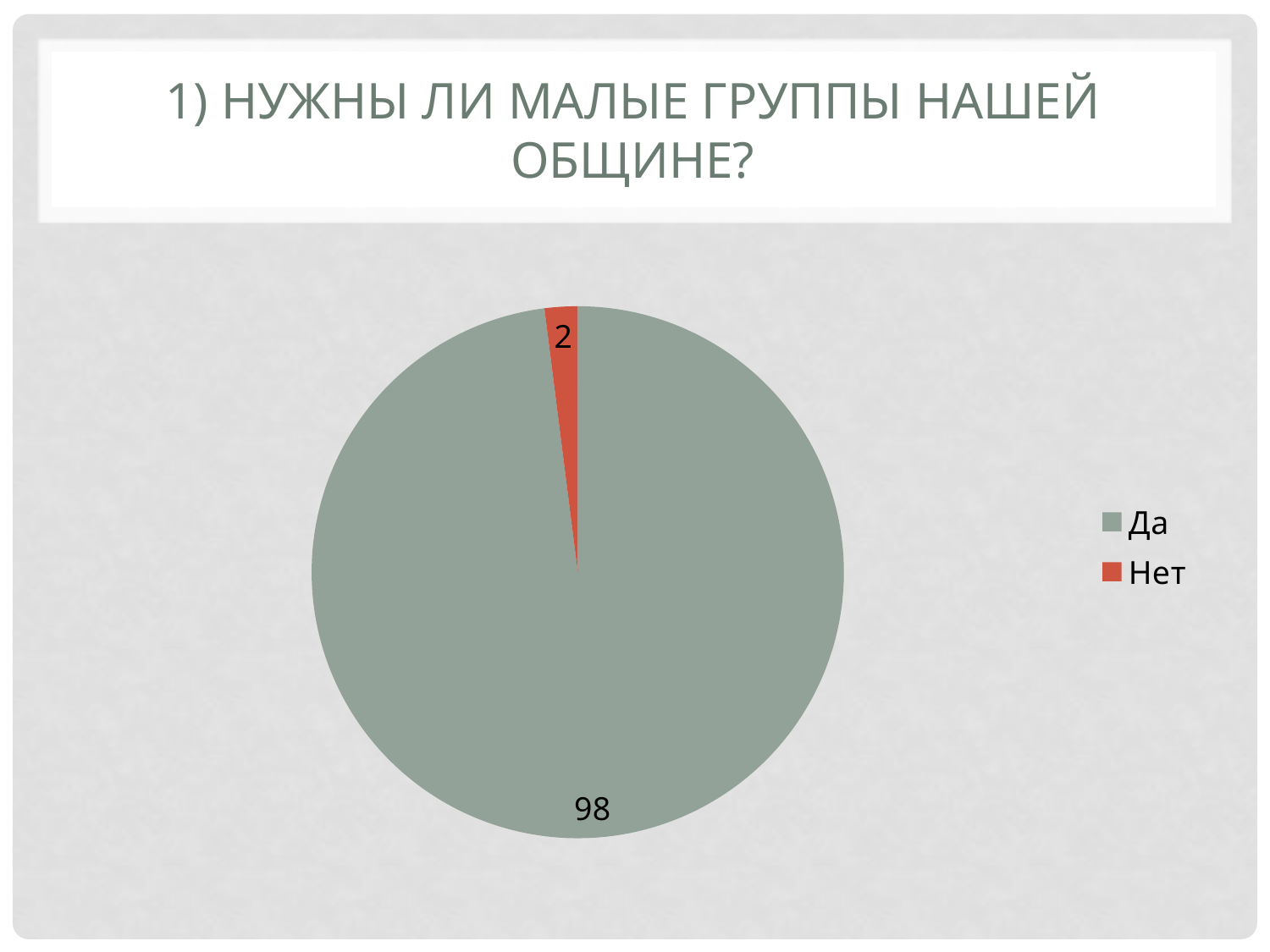
What is the value for "Нет"? 2 Which category has the largest slice? Да What colour is the "Нет" slice? red How many categories does the pie chart have? 2 Which category has the smallest slice? Нет How many entries does the legend list? 2 What is the value for "Да"? 98 What share of the pie does the "Нет" slice represent? 2% What type of chart is shown on the slide? pie chart Which is larger, the value for "Да" or the value for "Нет"? Да What is the title of the chart? 1) НУЖНЫ ЛИ МАЛЫЕ ГРУППЫ НАШЕЙ ОБЩИНЕ? What is the difference between the values for "Да" and "Нет"? 96